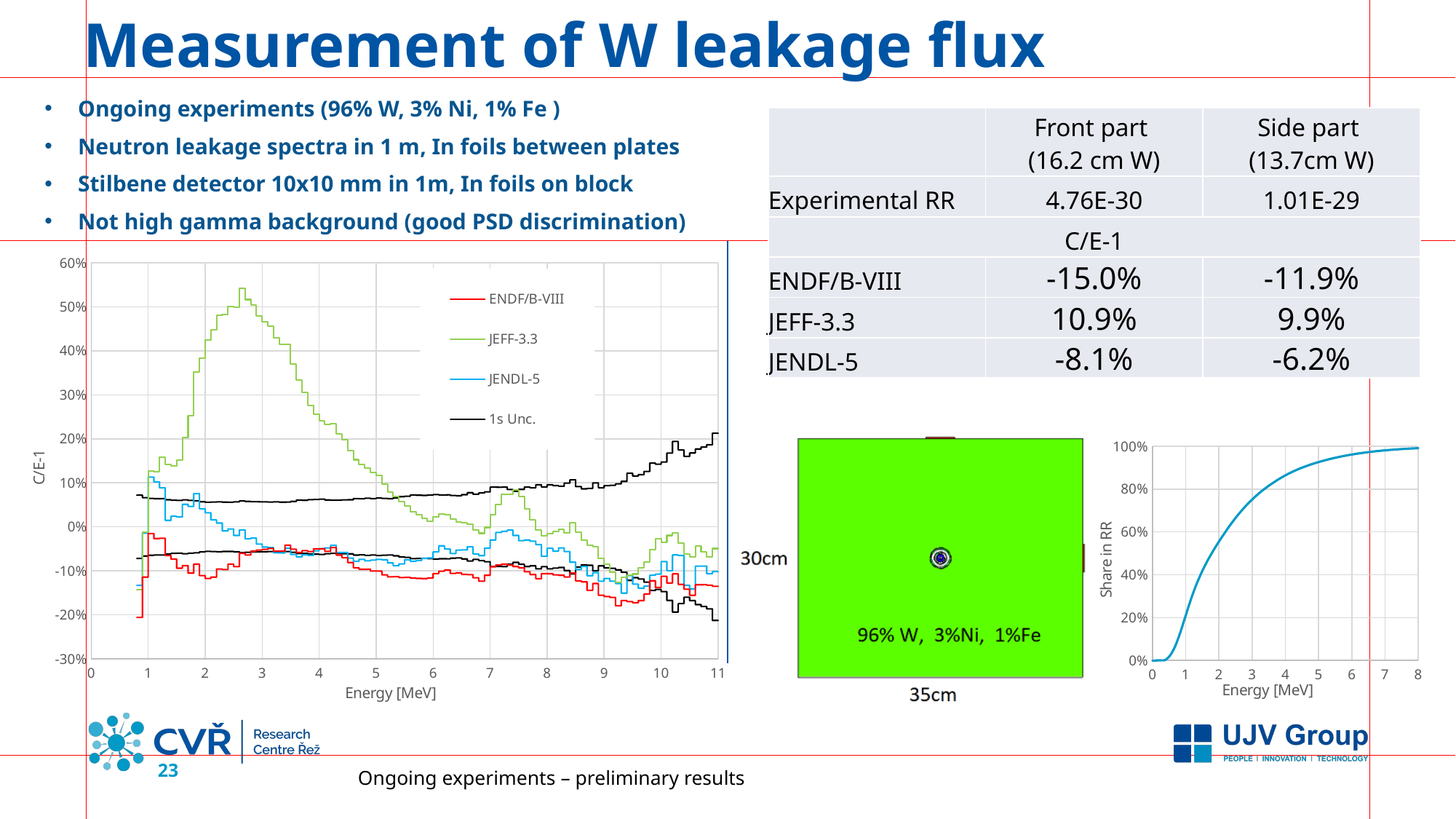
In the right Share in RR chart, is the value at 0.5 MeV greater or less than 20%? less In the right Share in RR chart, is the value at 4 MeV greater or less than 80%? greater In the left C/E-1 chart, which series reaches the highest value on the chart? JEFF-3.3 In the left C/E-1 chart, is the peak value of JEFF-3.3 near 2.7 MeV greater or less than 50%? greater In the right Share in RR chart, does the curve rise or fall as energy increases? rise In the left C/E-1 chart, which series is drawn in green? JEFF-3.3 In the left C/E-1 chart, how many series does the legend list? 4 In the left C/E-1 chart, at 2.5 MeV, which series has the larger value, JEFF-3.3 or ENDF/B-VIII? JEFF-3.3 In the left C/E-1 chart, what is the label of the x axis? Energy [MeV] What kind of chart is the left chart with C/E-1 on the vertical axis? line chart